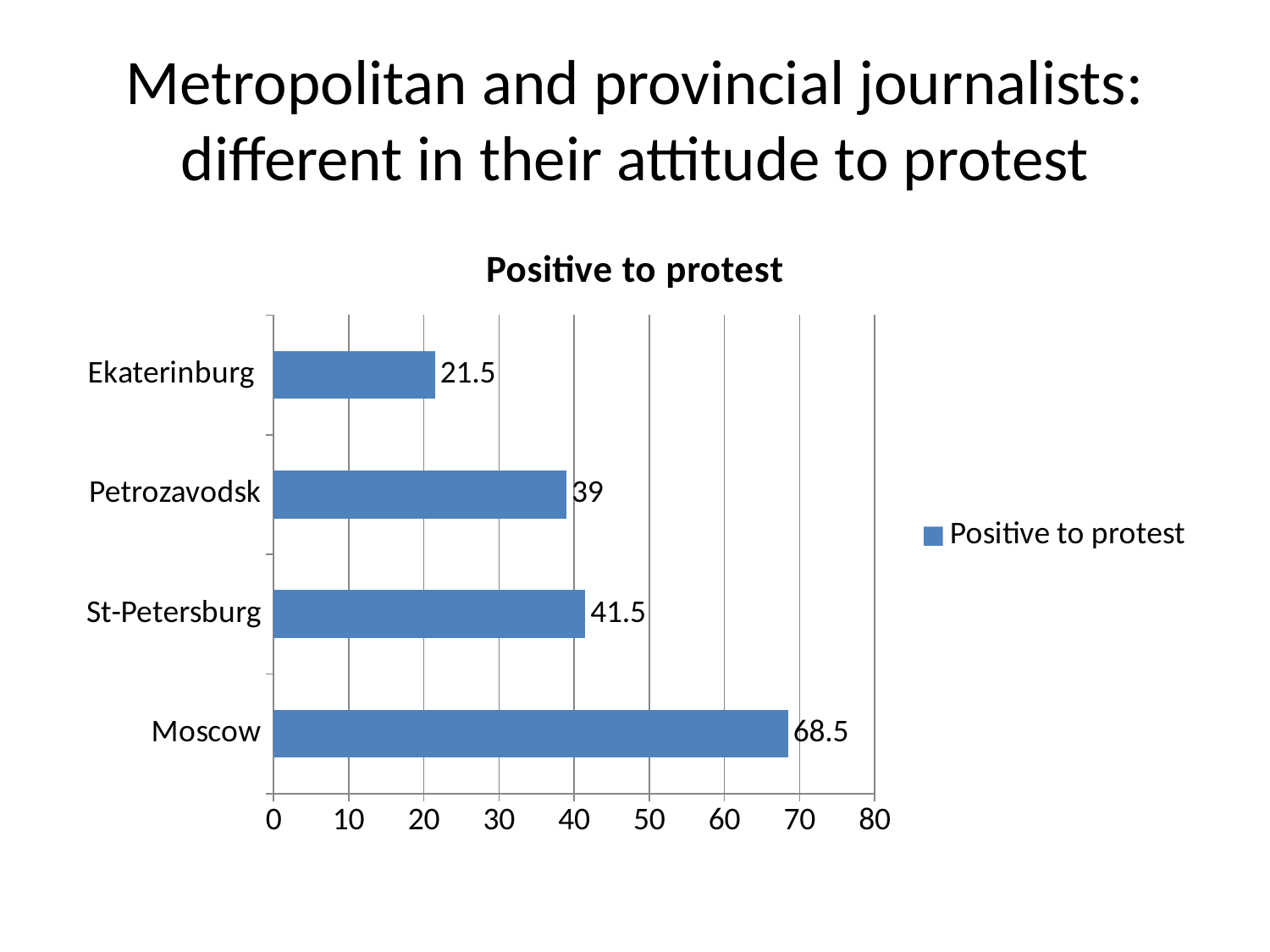
What is the value for Ekaterinburg? 21.5 How many cities are shown in the chart? 4 What is the difference between the values for Moscow and St-Petersburg? 27 Which city has the lowest value? Ekaterinburg What is the value for St-Petersburg? 41.5 Is the value for Moscow greater or less than 60? greater What kind of chart is shown on the slide? Bar chart What is the title of the chart? Positive to protest Which city has the highest value? Moscow What is the value for Moscow? 68.5 Which has a larger value, Moscow or Ekaterinburg? Moscow What is the value for Petrozavodsk? 39